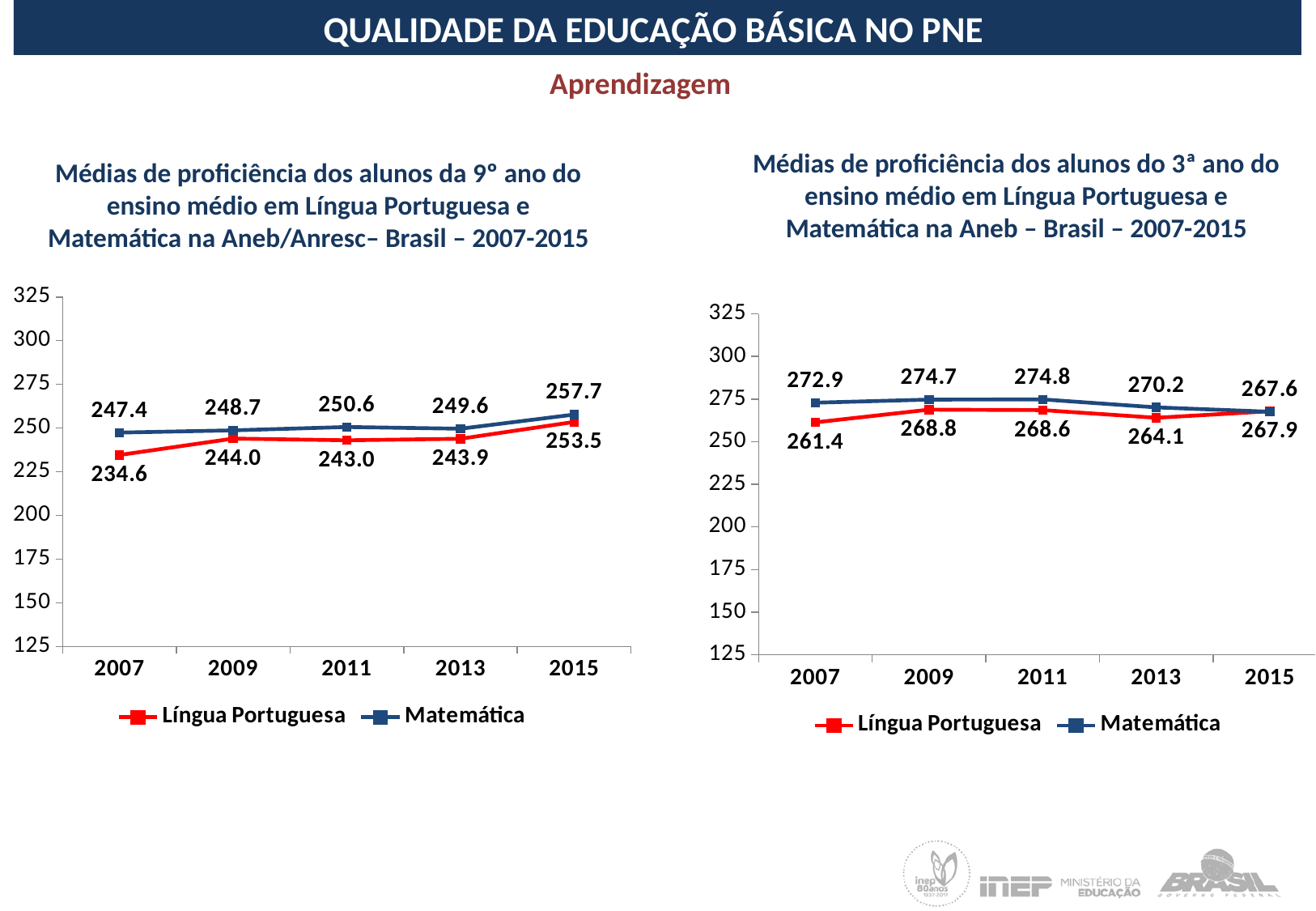
In the left chart (9º ano), what is the difference between the Matemática and Língua Portuguesa values in 2007? 12.8 In the left chart (9º ano), what is the Matemática value for 2015? 257.7 In the right chart (3ª ano do ensino médio), does the Matemática value rise or fall from 2011 to 2015? Fall In the right chart (3ª ano do ensino médio), which is larger in 2015: Língua Portuguesa or Matemática? Língua Portuguesa In the left chart (9º ano), what is the Língua Portuguesa value for 2007? 234.6 In the right chart (3ª ano do ensino médio), is the Língua Portuguesa value for 2007 greater or less than 250? greater What kind of chart is the left chart? Line chart In the right chart (3ª ano do ensino médio), in which year is the Matemática value highest? 2011 In the right chart (3ª ano do ensino médio), what is the Língua Portuguesa value for 2013? 264.1 In the left chart (9º ano), in which year is the Língua Portuguesa value lowest? 2007 How many years are plotted on the x axis of the left chart? 5 How many series does the legend of the right chart list? 2